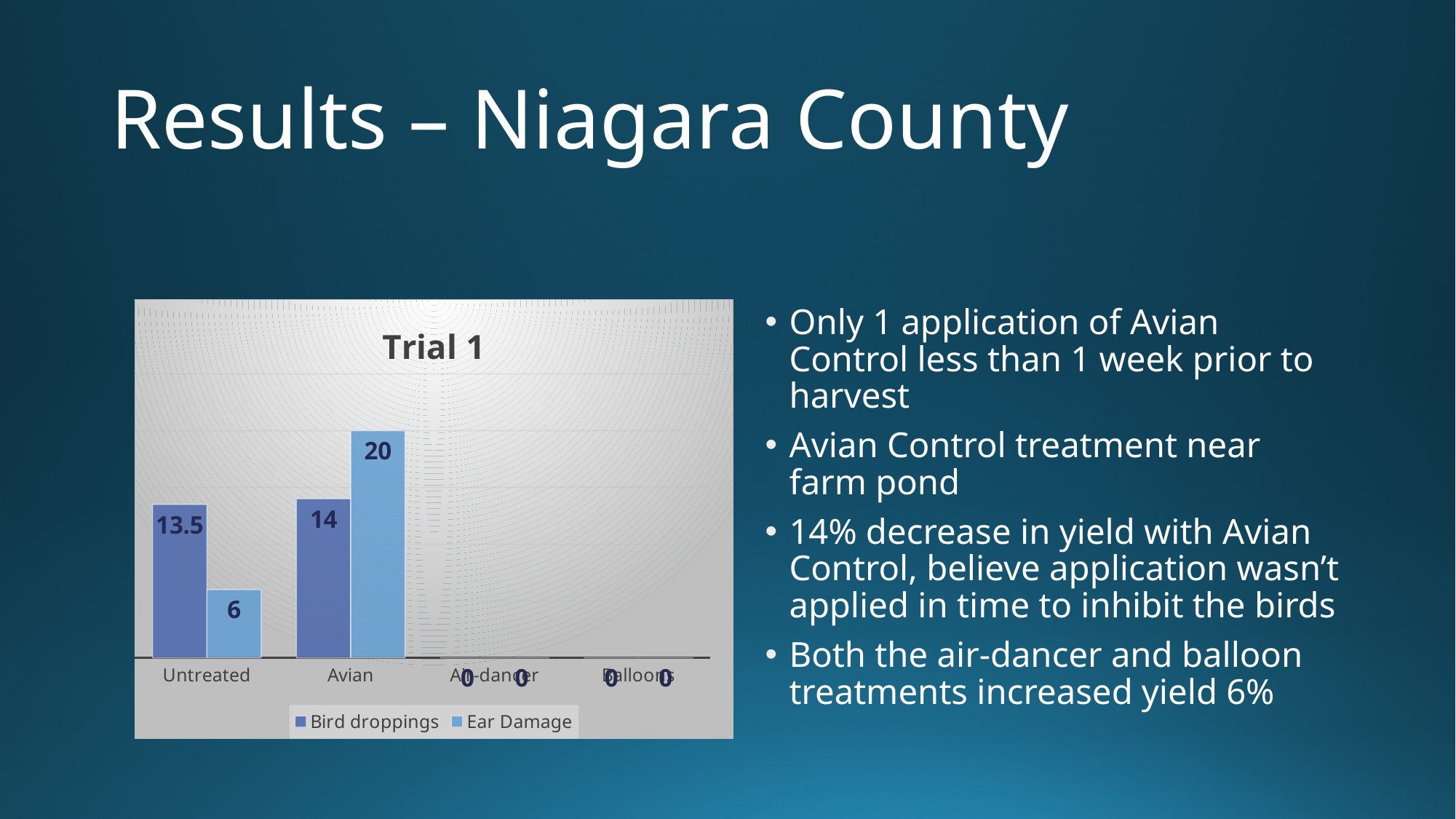
What is the Ear Damage value for Untreated in the Trial 1 chart? 6 In the Trial 1 chart, which is larger for Untreated: Bird droppings or Ear Damage? Bird droppings What is the Bird droppings value for Avian in the Trial 1 chart? 14 What is the Bird droppings value for Untreated in the Trial 1 chart? 13.5 What is the Ear Damage value for Avian in the Trial 1 chart? 20 What kind of chart is the Trial 1 chart? Bar chart How many categories are shown on the x axis of the Trial 1 chart? 4 Which category has the highest Ear Damage value in the Trial 1 chart? Avian What is the difference between the Bird droppings values for Avian and Untreated in the Trial 1 chart? 0.5 What is the title of the chart on the slide? Trial 1 How many series does the legend of the Trial 1 chart list? 2 What is the difference between the Ear Damage values for Avian and Untreated in the Trial 1 chart? 14